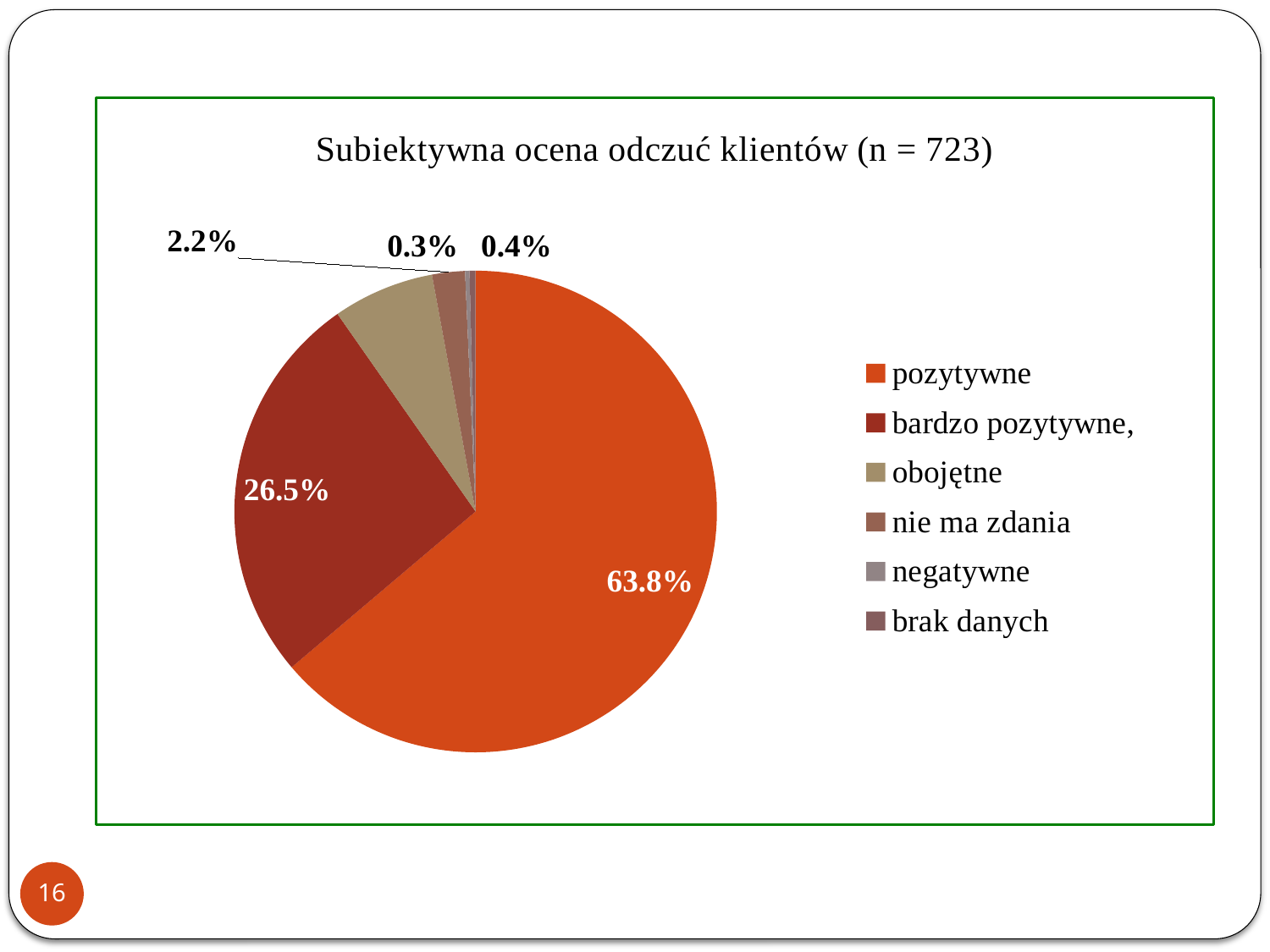
What percentage of the pie is labelled for the 'pozytywne' slice? 63.8% What is the difference in percentage points between the 'pozytywne' and 'bardzo pozytywne' slices? 37.3 Which is larger, the share for 'pozytywne' or for 'bardzo pozytywne'? pozytywne Which category has the largest share of the pie? pozytywne What type of chart is shown on the slide? pie chart What percentage is shown for the 'bardzo pozytywne' slice? 26.5% What is the smallest percentage label printed on the chart? 0.3% How many categories does the legend list? 6 What is the sample size (n) given in the chart title? 723 What is the combined share of the 'pozytywne' and 'bardzo pozytywne' slices? 90.3% What is the title of the chart? Subiektywna ocena odczuć klientów (n = 723)